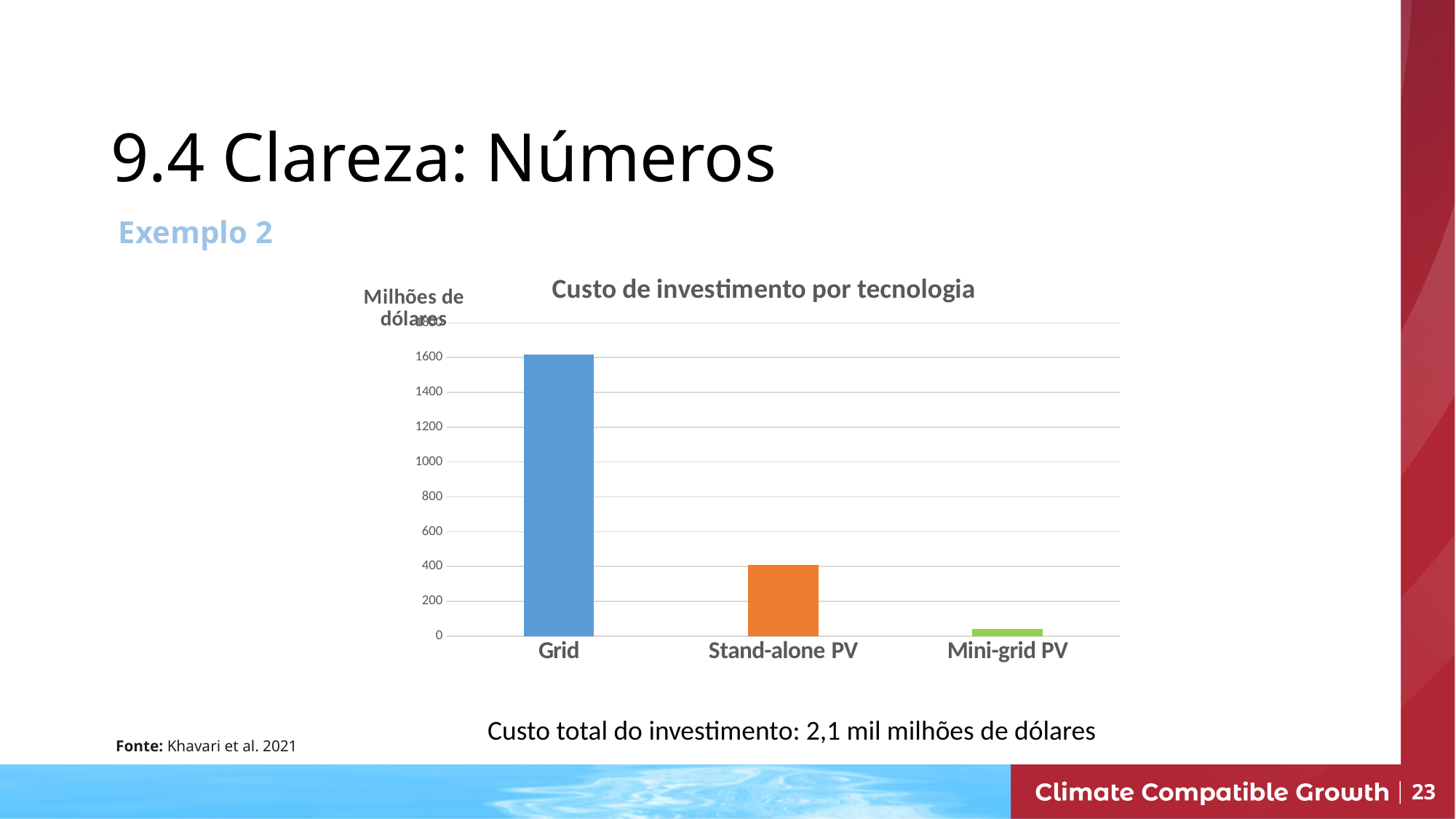
What unit is given for the y axis of the chart? Milhões de dólares Which has a larger investment cost, Stand-alone PV or Mini-grid PV? Stand-alone PV Which technology has the lowest investment cost? Mini-grid PV Is the investment cost for Mini-grid PV greater or less than 200? less How many technology categories are shown on the x axis? 3 Which has a larger investment cost, Grid or Stand-alone PV? Grid Is the investment cost for Stand-alone PV greater or less than 600? less Do the bar values rise or fall from left to right along the x axis? fall Which technology has the highest investment cost? Grid What type of chart is shown on the slide? bar chart What is the title of the chart? Custo de investimento por tecnologia Is the investment cost for Grid greater or less than 1400? greater